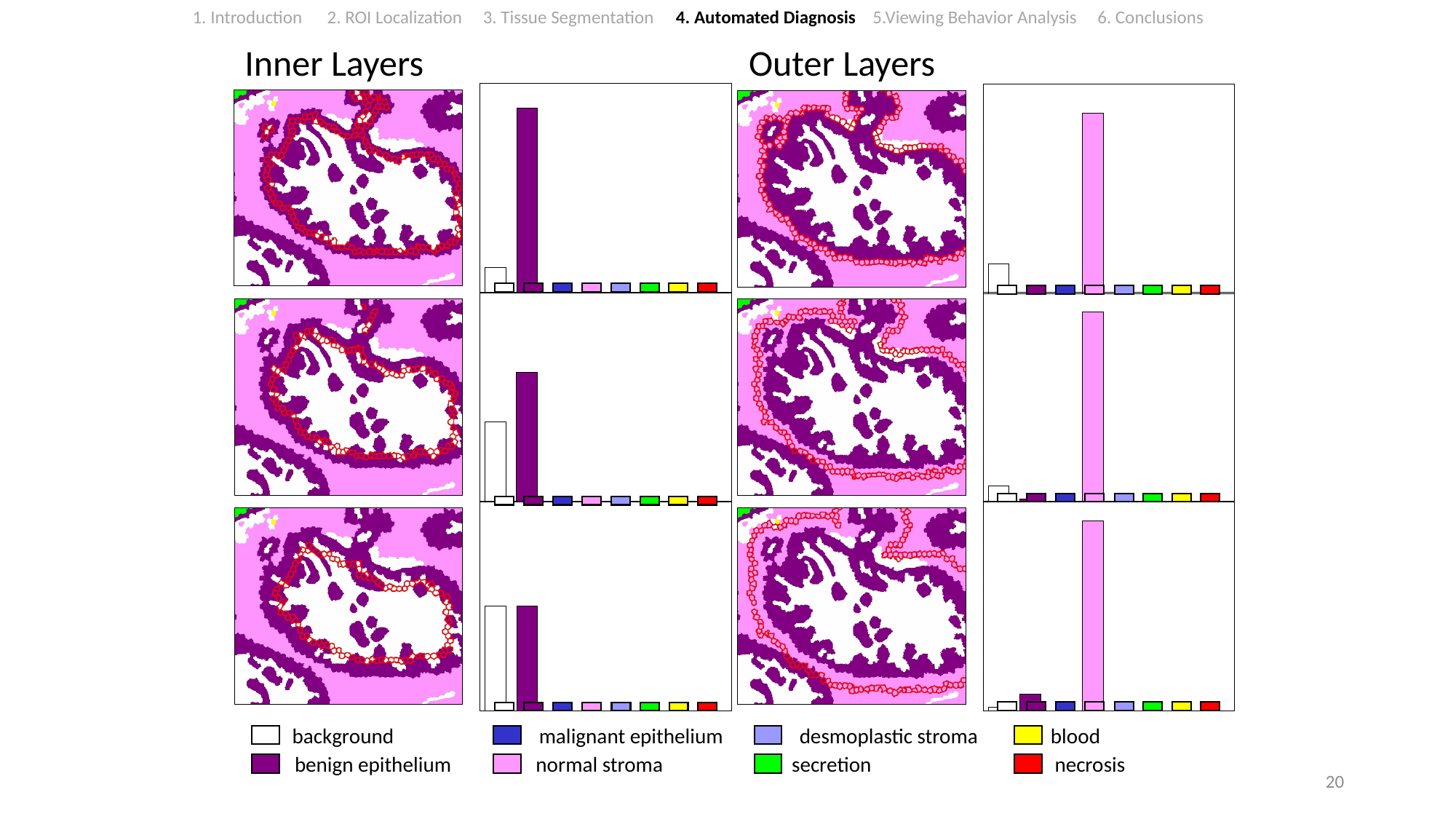
In the top chart under the Inner Layers heading, which tissue class has the tallest bar? benign epithelium How many tissue classes does the legend at the bottom of the slide list? 8 According to the legend, what colour represents normal stroma in the charts? pink What kind of chart is shown in the top chart under the Inner Layers heading? bar chart How many bars does the top chart under the Inner Layers heading contain? 8 According to the legend, what colour represents necrosis in the charts? red How many bar charts are shown on the slide in total? 6 In the bottom chart under the Outer Layers heading, which tissue class has the tallest bar? normal stroma In the middle chart under the Inner Layers heading, which tissue class has the tallest bar? benign epithelium In the middle chart under the Outer Layers heading, which bar is taller: normal stroma or background? normal stroma In the top chart under the Inner Layers heading, which bar is taller: background or benign epithelium? benign epithelium